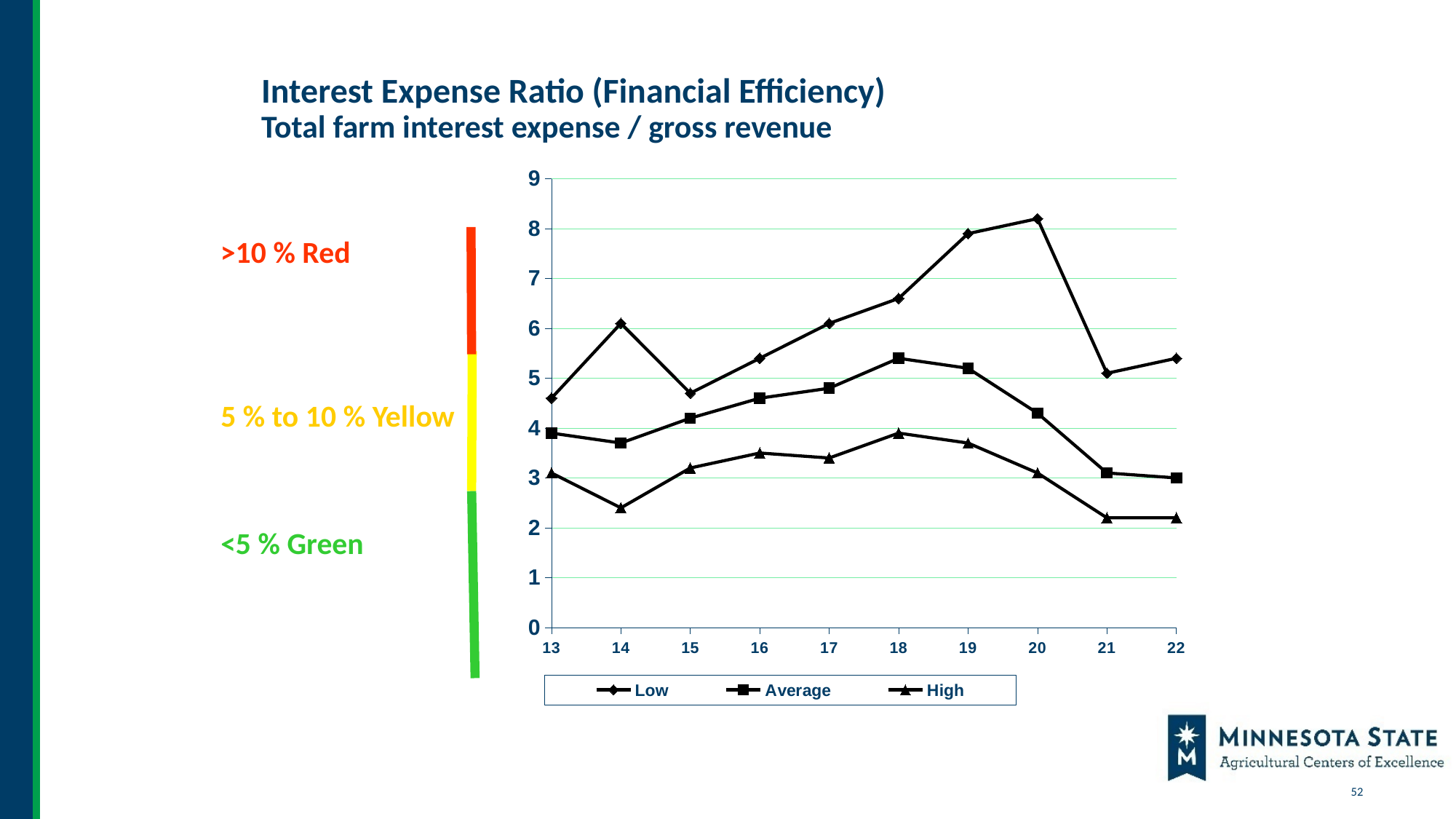
How many years are plotted along the x axis? 10 How many series does the legend list? 3 Is the value for the Low series in year 18 greater or less than 6? greater Is the value for the Low series in year 19 greater or less than 7? greater In year 14, which series has the larger value, Average or High? Average What are the three series named in the legend? Low, Average, High Is the value for the High series in year 14 greater or less than 3? less Does the Low series rise or fall from year 20 to year 21? fall What kind of chart is shown on the slide? line chart In which year does the Low series reach its highest value? 20 In year 20, which series has the larger value, Low or Average? Low